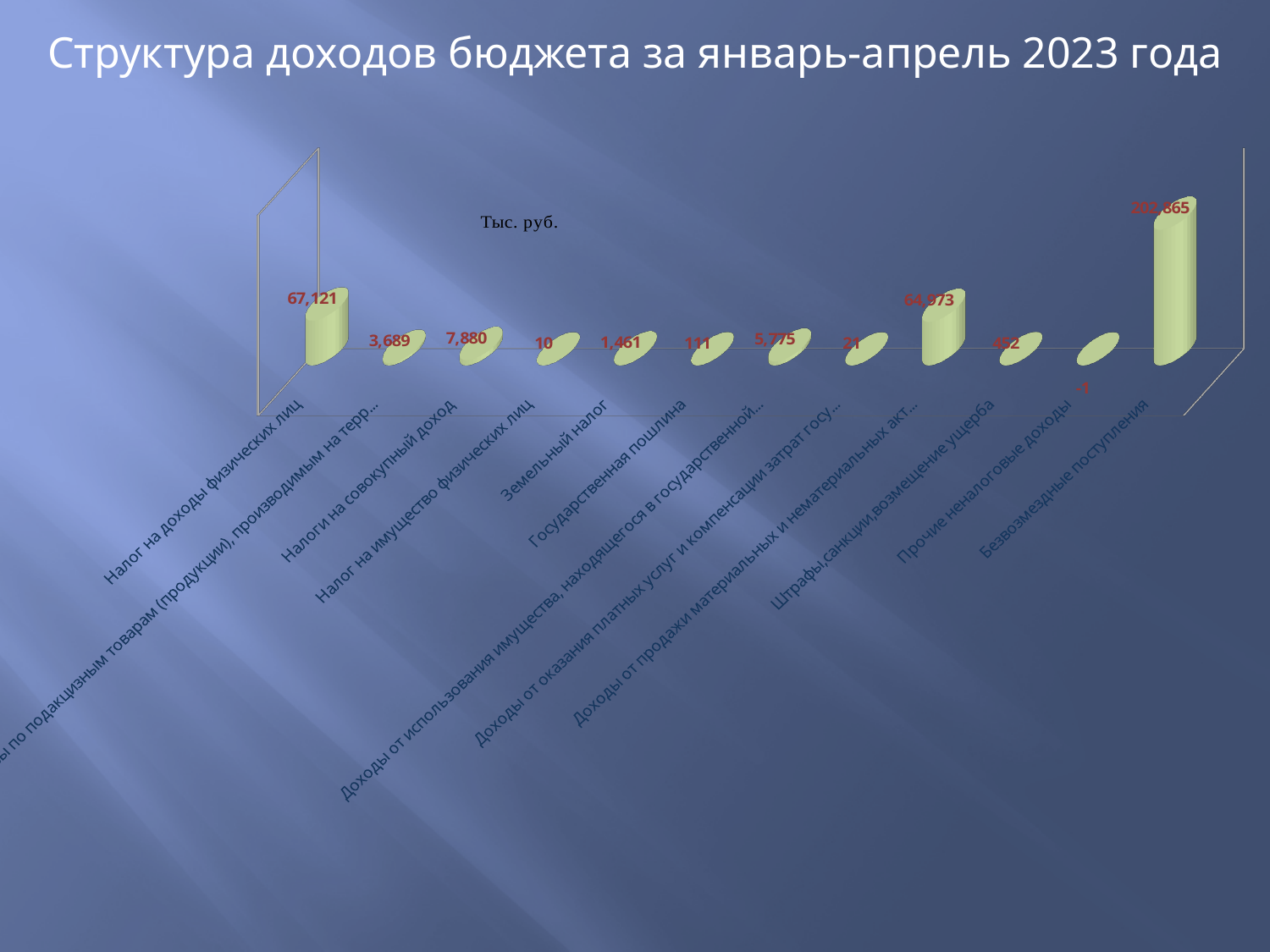
How many categories are shown in the chart? 12 What is the value for Прочие неналоговые доходы? -1 What is the value for Налог на доходы физических лиц? 67,121 What is the value for Земельный налог? 1,461 What is the difference between the values for Налог на доходы физических лиц and Доходы от продажи материальных и нематериальных акт...? 2,148 What is the value for Штрафы,санкции,возмещение ущерба? 452 What kind of chart is shown on the slide? Bar chart Which category has the lowest value? Прочие неналоговые доходы What is the value for Безвозмездные поступления? 202,865 Which category has the highest value? Безвозмездные поступления What unit is indicated on the chart? Тыс. руб. Which is larger: the value for Земельный налог or the value for Государственная пошлина? Земельный налог